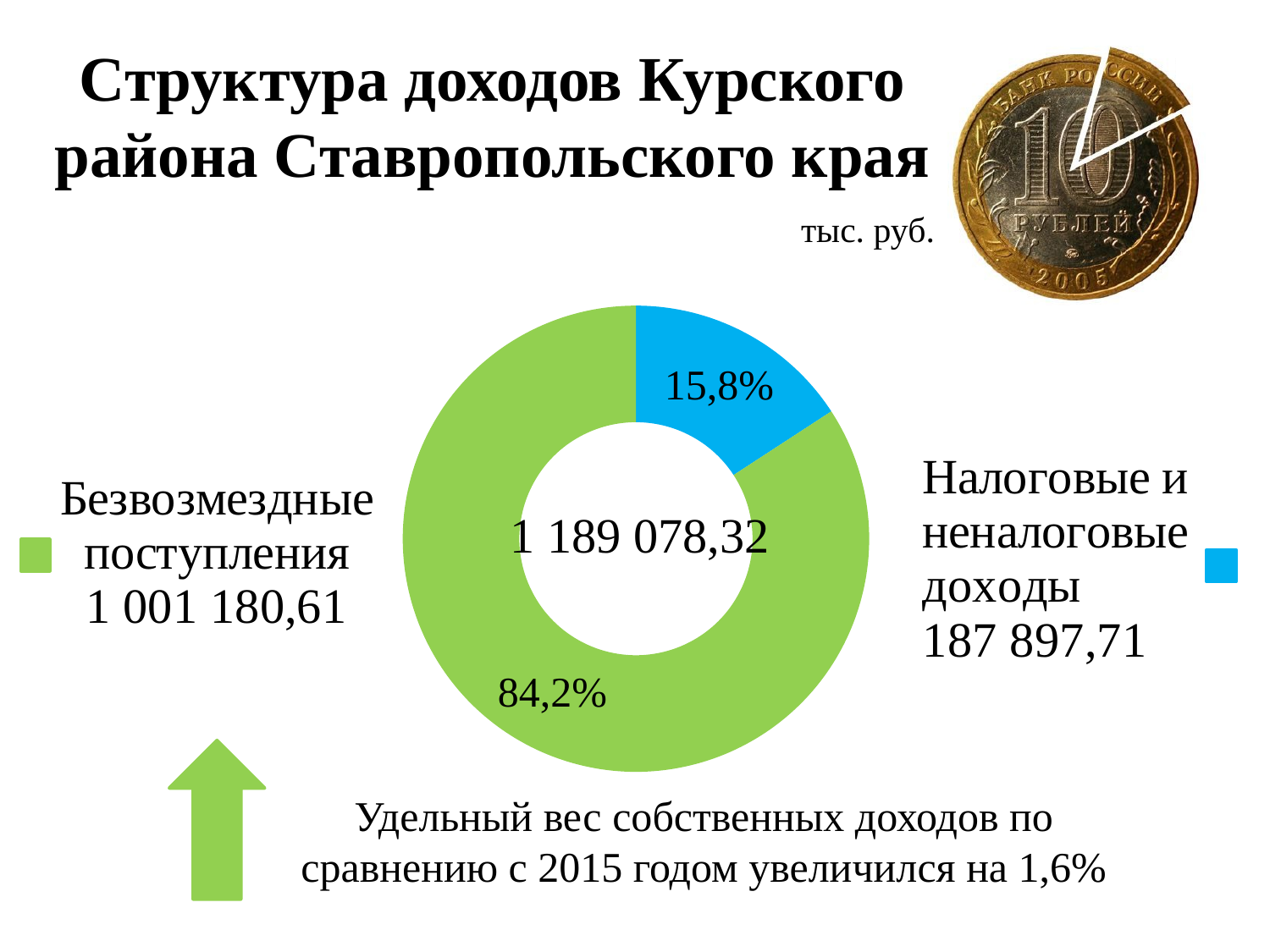
What is the difference in percentage points between the two slices (84,2% and 15,8%)? 68,4 What total value is printed in the centre of the donut chart? 1 189 078,32 What kind of chart is shown on the slide? Pie (donut) chart What colour is the slice for "Налоговые и неналоговые доходы"? Blue What value is shown for "Безвозмездные поступления"? 1 001 180,61 How many slices does the donut chart have? 2 Which is larger: "Безвозмездные поступления" or "Налоговые и неналоговые доходы"? Безвозмездные поступления What share of the chart is labelled for "Налоговые и неналоговые доходы"? 15,8% Which category has the smallest slice of the chart? Налоговые и неналоговые доходы Which category has the largest slice of the chart? Безвозмездные поступления What value is shown for "Налоговые и неналоговые доходы"? 187 897,71 What share of the chart is labelled for "Безвозмездные поступления"? 84,2%